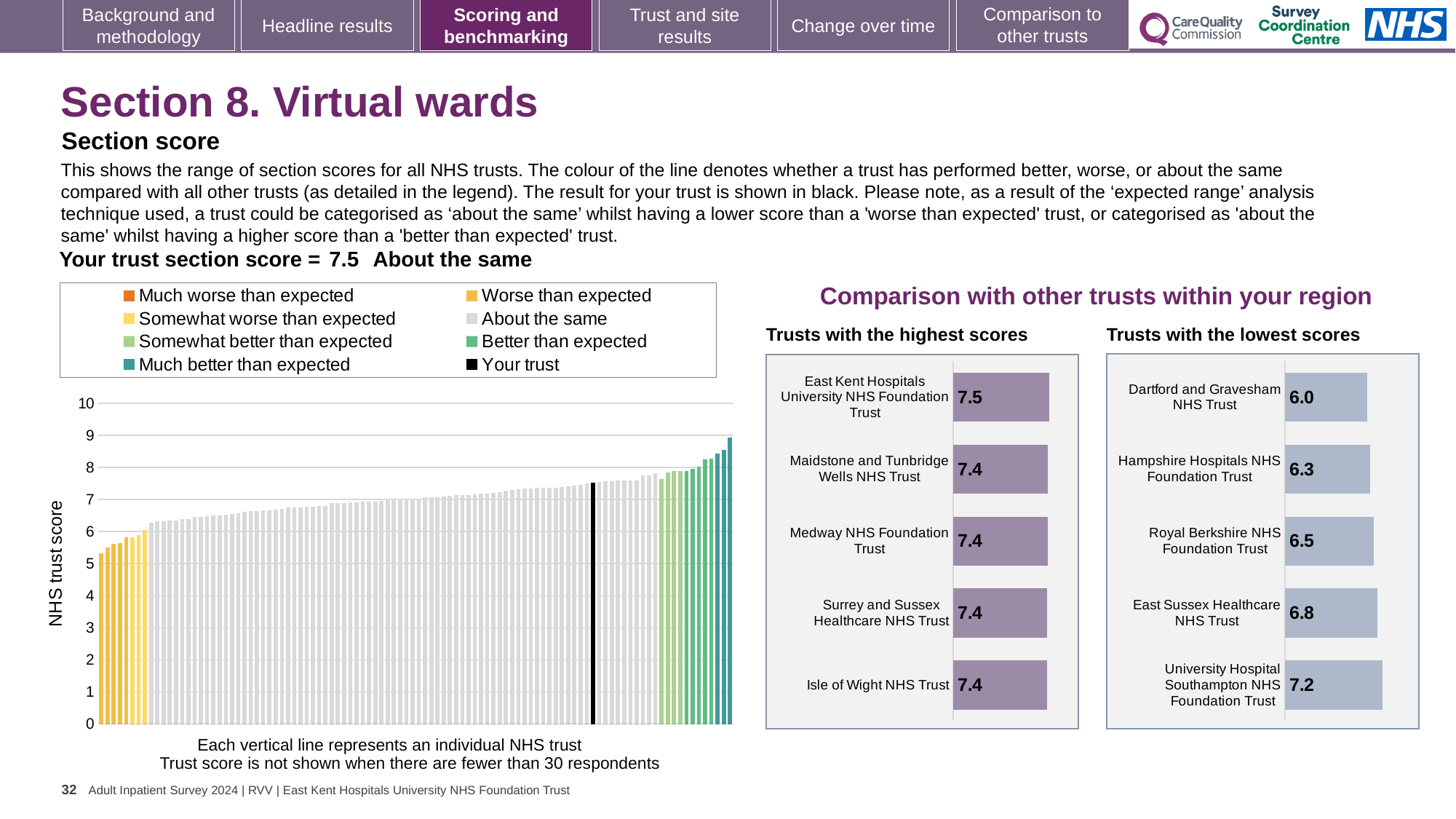
In the 'Trusts with the lowest scores' chart, which has the higher score: Hampshire Hospitals NHS Foundation Trust or Royal Berkshire NHS Foundation Trust? Royal Berkshire NHS Foundation Trust In the 'Trusts with the lowest scores' chart, which trust has the highest score? University Hospital Southampton NHS Foundation Trust In the 'Trusts with the highest scores' chart, what is the difference between the scores of East Kent Hospitals University NHS Foundation Trust and Maidstone and Tunbridge Wells NHS Trust? 0.1 What kind of chart is the 'Trusts with the highest scores' chart? Bar chart In the 'Trusts with the highest scores' chart, what is the score for East Kent Hospitals University NHS Foundation Trust? 7.5 What is the title above the two smaller charts on the right of the slide? Comparison with other trusts within your region In the 'Trusts with the lowest scores' chart, what is the score for Dartford and Gravesham NHS Trust? 6.0 How many trusts are shown in the 'Trusts with the highest scores' chart? 5 In the 'Trusts with the lowest scores' chart, which trust has the lowest score? Dartford and Gravesham NHS Trust In the NHS trust score chart on the left, do the values rise or fall from left to right? Rise In the 'Trusts with the lowest scores' chart, what is the difference between the scores of University Hospital Southampton NHS Foundation Trust and Dartford and Gravesham NHS Trust? 1.2 How many entries does the legend of the NHS trust score chart on the left list? 8